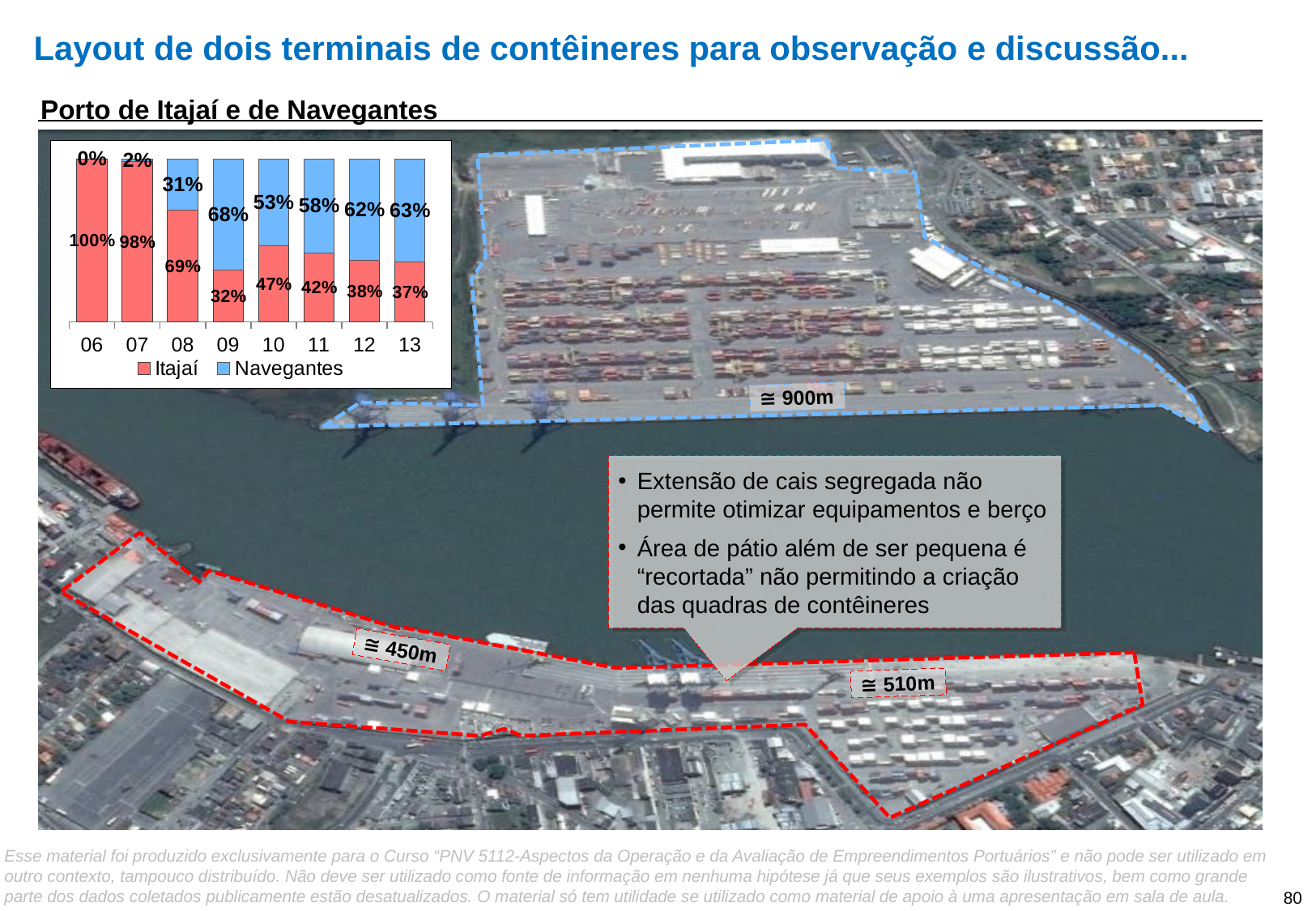
Which is larger in 10: the Itajaí value or the Navegantes value? Navegantes What is the value for Navegantes in 08? 31% Which colour represents Navegantes in the chart? Blue Does the Itajaí share generally rise or fall from 06 to 13? Fall What is the value for Navegantes in 12? 62% How many series does the chart legend list? 2 In which year is the Itajaí share highest? 06 What kind of chart is shown on the slide? Stacked bar chart How many years are shown on the x axis of the chart? 8 In which year is the Navegantes share lowest? 06 What is the difference between the Itajaí value in 06 and the Itajaí value in 13? 63% What is the value for Itajaí in 09? 32%